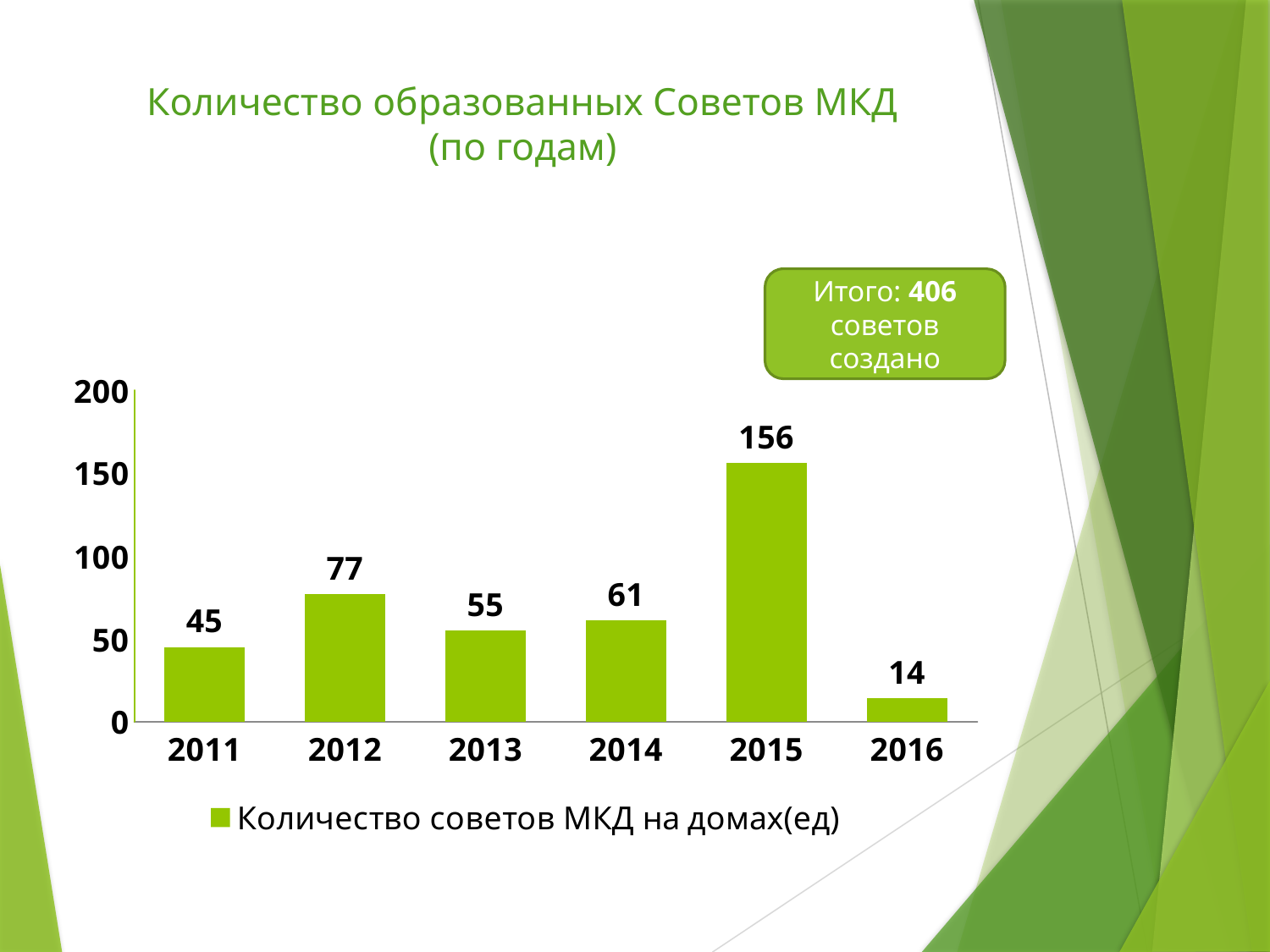
What is the difference between the values for 2015 and 2014? 95 How many years are shown on the x axis? 6 What is the value for 2013? 55 Which is larger, the value for 2012 or the value for 2014? 2012 What is the value for 2011? 45 How many series does the legend list? 1 What kind of chart is shown? bar chart Which year has the lowest value? 2016 Which year has the highest value? 2015 What is the value for 2015? 156 What is the difference between the values for 2012 and 2011? 32 What is the legend entry for the series? Количество советов МКД на домах(ед)